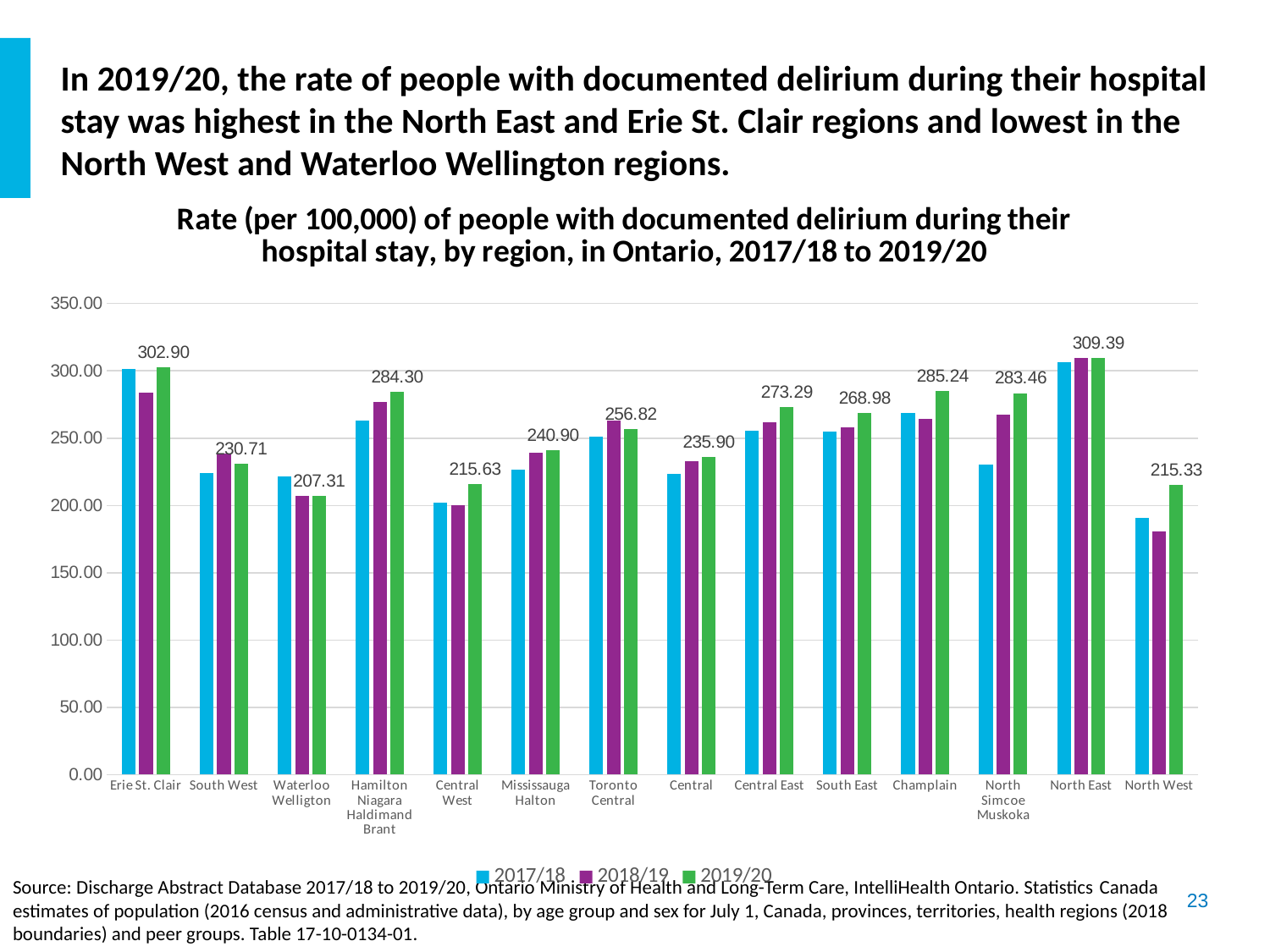
Is the 2018/19 value for Hamilton Niagara Haldimand Brant greater or less than 250? greater What is the 2019/20 rate for Waterloo Wellington? 207.31 Which region has the lowest 2019/20 rate? Waterloo Wellington What is the 2019/20 rate for Mississauga Halton? 240.90 What is the difference between the 2019/20 rates for North East and Waterloo Wellington? 102.08 Which has the larger 2019/20 rate, Central East or South East? Central East Is the 2017/18 value for North West greater or less than 200? less Which region has the highest 2019/20 rate? North East How many series does the legend list? 3 What kind of chart is shown on the slide? Bar chart How many regions are shown on the x axis? 14 What is the 2019/20 rate for the North East region? 309.39